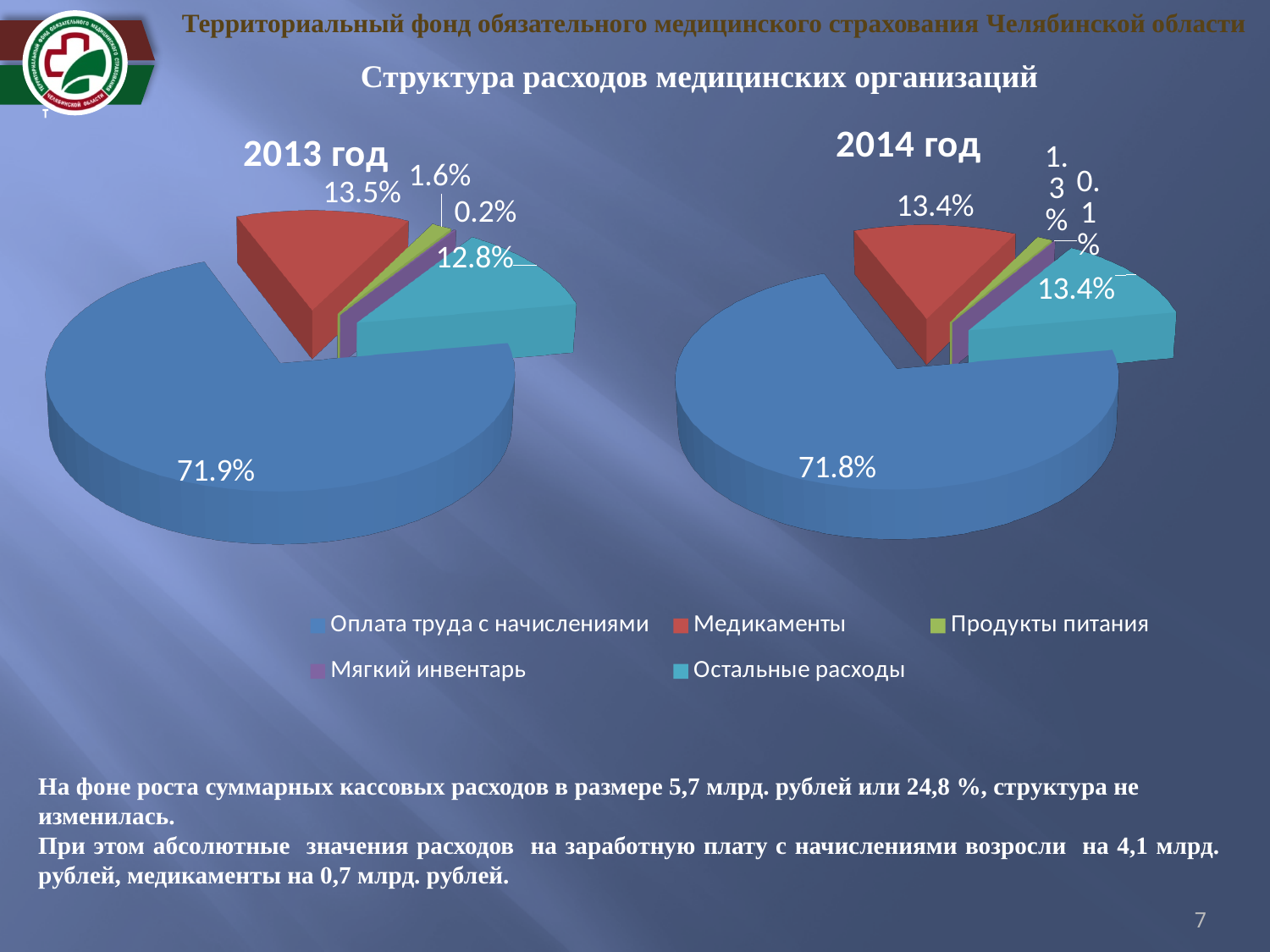
In the 2013 год chart, what is the difference between the shares of Медикаменты and Остальные расходы? 0.7 percentage points What type of chart is used for the 2013 год and 2014 год data? Pie chart How many categories does the legend list? 5 In the 2013 год chart, what is the difference between the shares of Оплата труда с начислениями and Медикаменты? 58.4 percentage points In the 2014 год chart, what share is shown for Медикаменты? 13.4% In the 2013 год chart, which category has the largest slice? Оплата труда с начислениями In the 2013 год chart, what share is shown for Медикаменты? 13.5% Which chart shows a larger share for Оплата труда с начислениями, 2013 год or 2014 год? 2013 год In the 2014 год chart, what share is shown for Оплата труда с начислениями? 71.8% In the 2013 год chart, what share is shown for Остальные расходы? 12.8% In the 2013 год chart, which category has the smallest slice? Мягкий инвентарь In the 2013 год chart, what share is shown for Оплата труда с начислениями? 71.9%